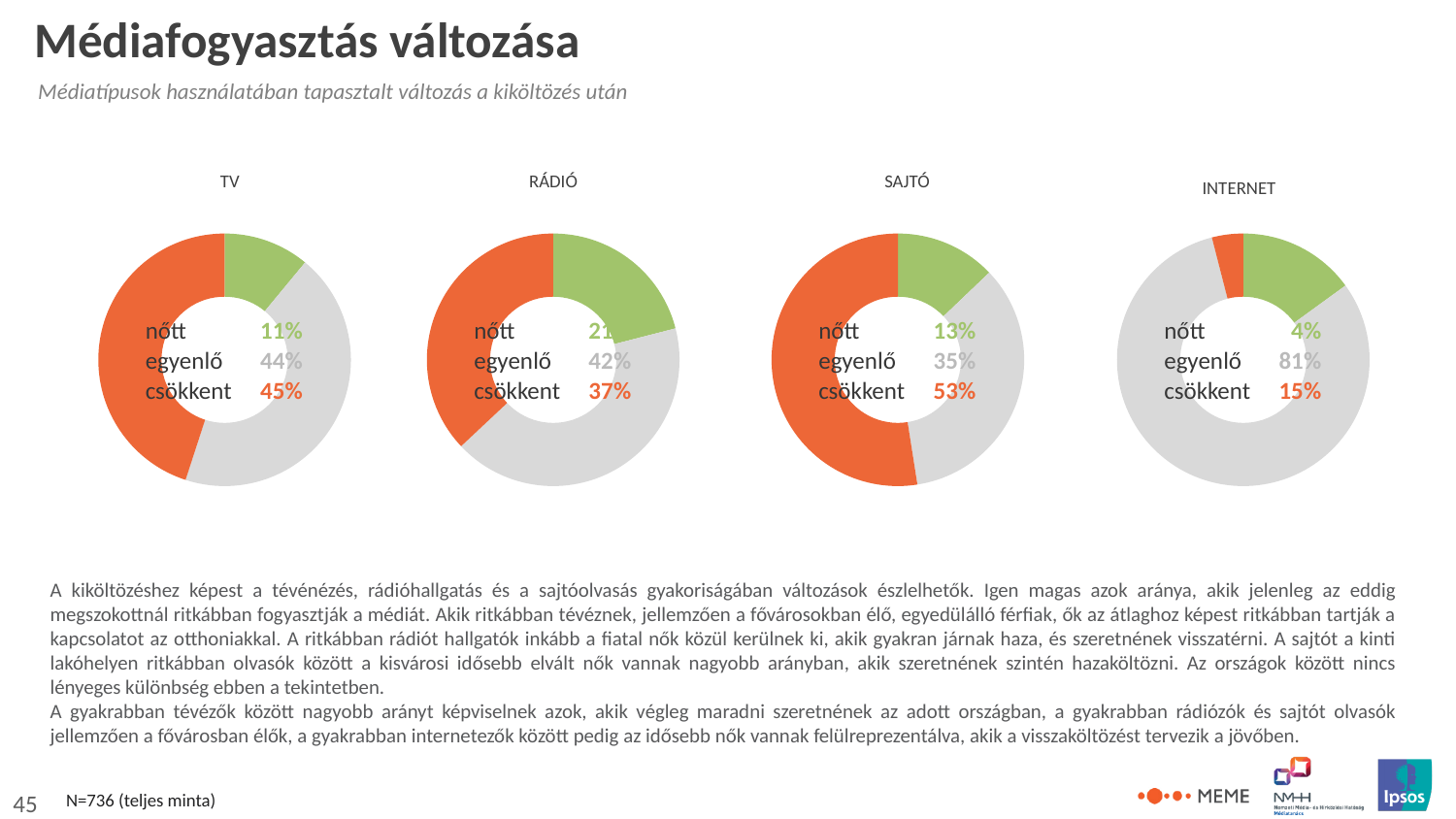
Which chart shows the highest "csökkent" percentage: TV, RÁDIÓ, SAJTÓ or INTERNET? SAJTÓ In the SAJTÓ chart, what percentage is shown for "egyenlő"? 35% In the INTERNET chart, which category has the largest share? egyenlő How many donut charts are shown on the slide? 4 What type of chart is used for the TV data? Donut (pie) chart In the TV chart, what percentage is shown for "csökkent"? 45% In the SAJTÓ chart, what is the difference between the "csökkent" and "nőtt" percentages? 40% In the INTERNET chart, what percentage is shown for "nőtt"? 4% In the RÁDIÓ chart, what percentage is shown for "csökkent"? 37% In the SAJTÓ chart, which category has the smallest share? nőtt In the RÁDIÓ chart, which is larger: "egyenlő" or "csökkent"? egyenlő In the INTERNET chart, what is the difference between the "egyenlő" and "csökkent" percentages? 66%